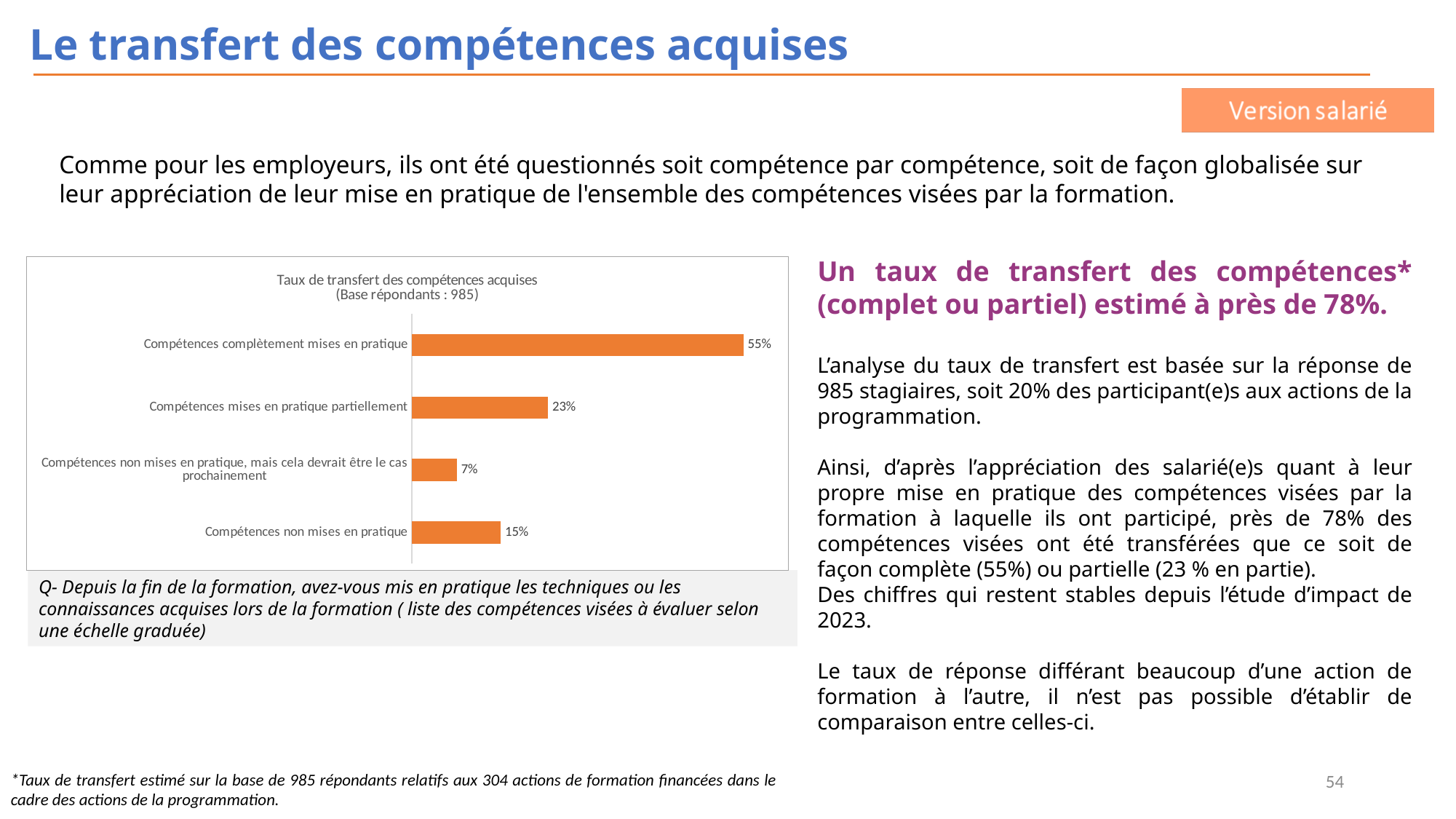
What is the difference between the values for "Compétences complètement mises en pratique" and "Compétences mises en pratique partiellement"? 32% What is the title of the chart? Taux de transfert des compétences acquises (Base répondants : 985) How many categories are shown in the chart? 4 What is the value for "Compétences mises en pratique partiellement"? 23% Which is larger: the value for "Compétences mises en pratique partiellement" or for "Compétences non mises en pratique"? Compétences mises en pratique partiellement What is the value for "Compétences complètement mises en pratique"? 55% What is the value for "Compétences non mises en pratique"? 15% Which category has the lowest value? Compétences non mises en pratique, mais cela devrait être le cas prochainement What is the value for "Compétences non mises en pratique, mais cela devrait être le cas prochainement"? 7% What is the difference between the values for "Compétences non mises en pratique" and "Compétences non mises en pratique, mais cela devrait être le cas prochainement"? 8% What kind of chart is shown on the slide? Bar chart Which category has the highest value? Compétences complètement mises en pratique